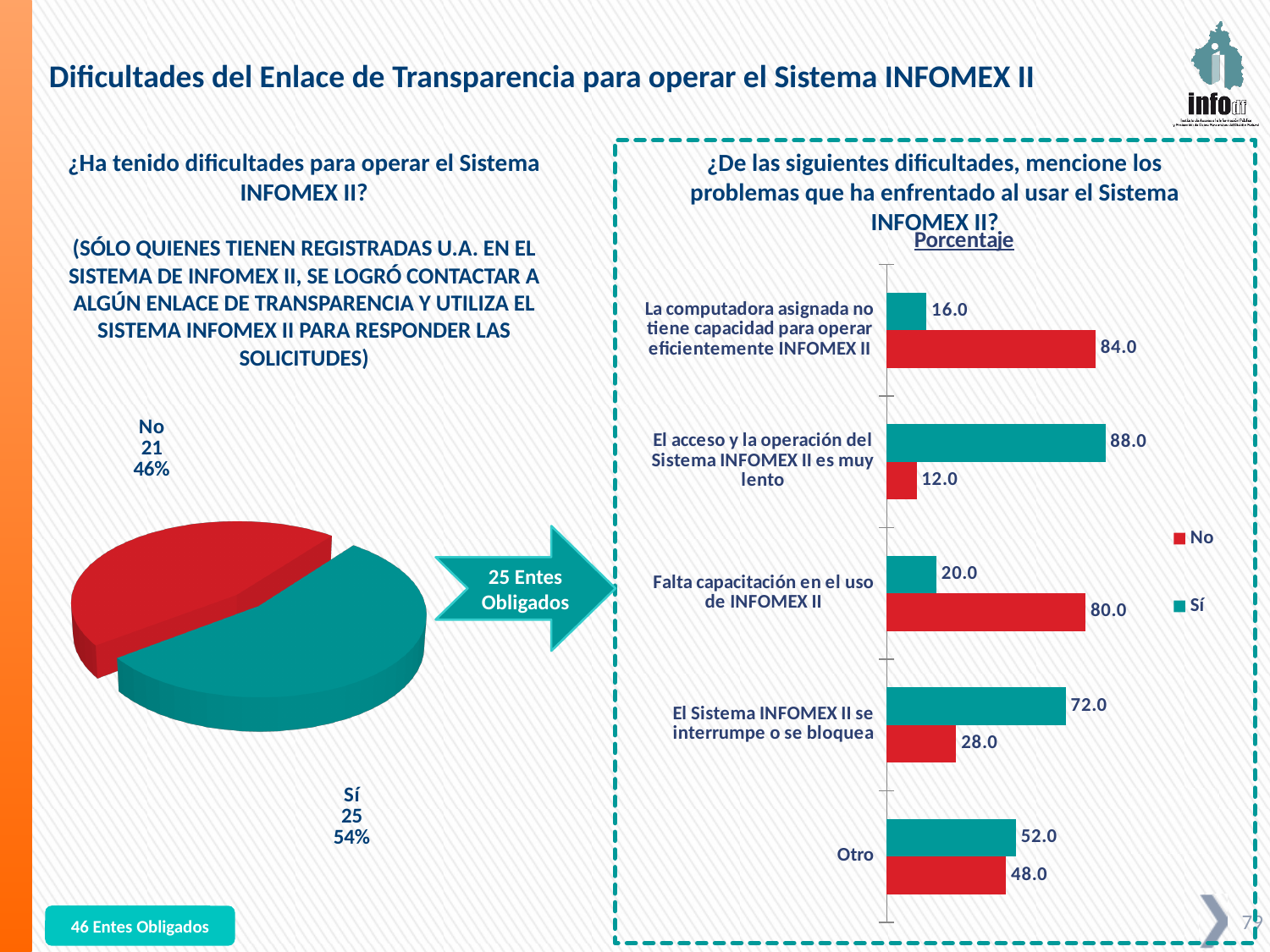
In the bar chart on the right, what is the difference between the "Sí" and "No" values for "El Sistema INFOMEX II se interrumpe o se bloquea"? 44.0 What kind of chart is shown on the left side of the slide? Pie chart In the pie chart on the left, what percentage of respondents answered "Sí"? 54% In the bar chart on the right, which category has the highest "Sí" value? El acceso y la operación del Sistema INFOMEX II es muy lento In the bar chart on the right, what is the "Sí" value for "El acceso y la operación del Sistema INFOMEX II es muy lento"? 88.0 In the bar chart on the right, which category has the lowest "Sí" value? La computadora asignada no tiene capacidad para operar eficientemente INFOMEX II How many series does the legend of the bar chart on the right list? 2 How many categories are shown in the bar chart on the right? 5 In the bar chart on the right, what is the "No" value for "Falta capacitación en el uso de INFOMEX II"? 80.0 In the pie chart on the left, how many respondents answered "No"? 21 In the pie chart on the left, which answer has the larger share, "Sí" or "No"? Sí What kind of chart is shown on the right side of the slide? Bar chart